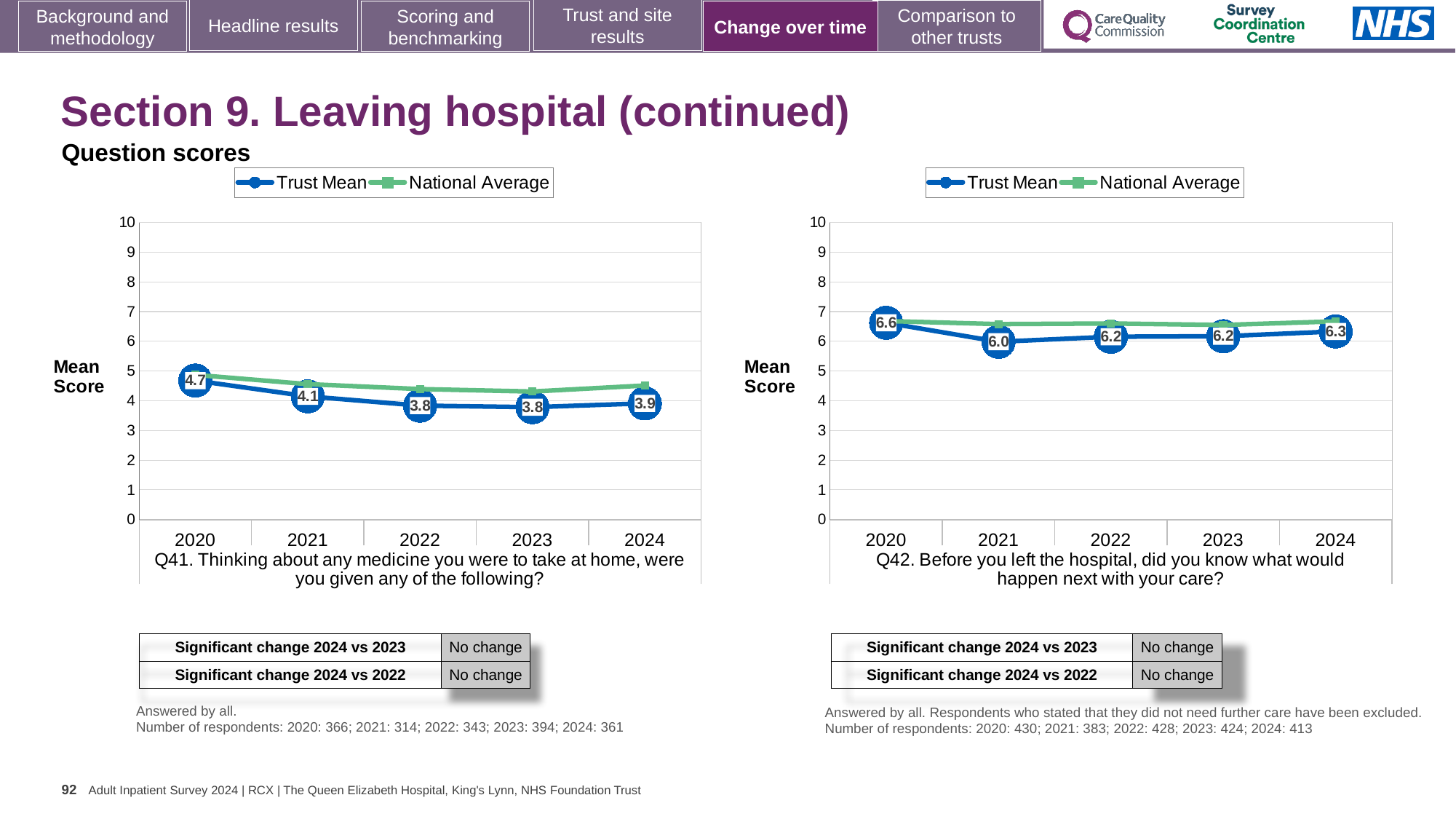
In the Q41 chart (left), which year has the highest Trust Mean score? 2020 In the Q42 chart (right), which is larger, the Trust Mean score for 2020 or for 2021? 2020 In the Q42 chart (right), what is the difference between the Trust Mean scores for 2020 and 2021? 0.6 In the Q41 chart (left), is the Trust Mean score for 2021 greater or less than 5? less In the Q41 chart (left), what is the difference between the Trust Mean scores for 2020 and 2024? 0.8 How many series does the legend of the Q41 chart (left) list? 2 In the Q41 chart (left), what is the Trust Mean score for 2020? 4.7 In the Q42 chart (right), what is the Trust Mean score for 2024? 6.3 What kind of chart is the Q42 chart (right)? Line chart In the Q41 chart (left), what is the Trust Mean score for 2024? 3.9 In the Q42 chart (right), which year has the lowest Trust Mean score? 2021 In the Q42 chart (right), what is the Trust Mean score for 2021? 6.0